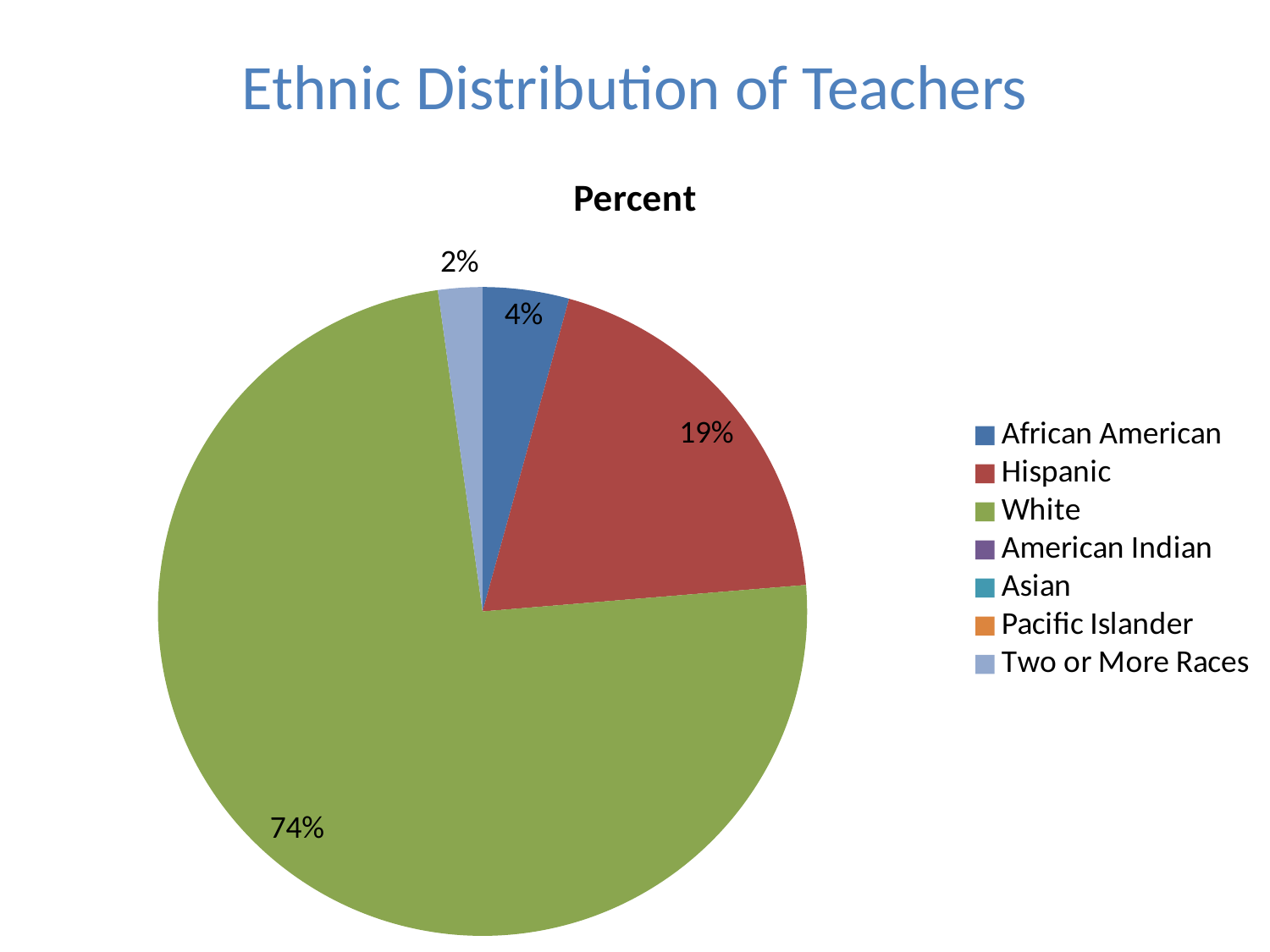
What is the difference in percentage points between the Hispanic and African American shares? 15% What percentage of teachers are White according to the pie chart? 74% What type of chart is shown on the slide? Pie chart What is the title of the slide? Ethnic Distribution of Teachers Which share is larger, African American or Two or More Races? African American Which ethnic group has the largest share of teachers? White What percentage of teachers are of Two or More Races? 2% How many ethnic categories are listed in the legend? 7 What is the difference in percentage points between the White and Hispanic shares? 55% What percentage of teachers are Hispanic? 19% What percentage of teachers are African American? 4% Which share is larger, Hispanic or African American? Hispanic